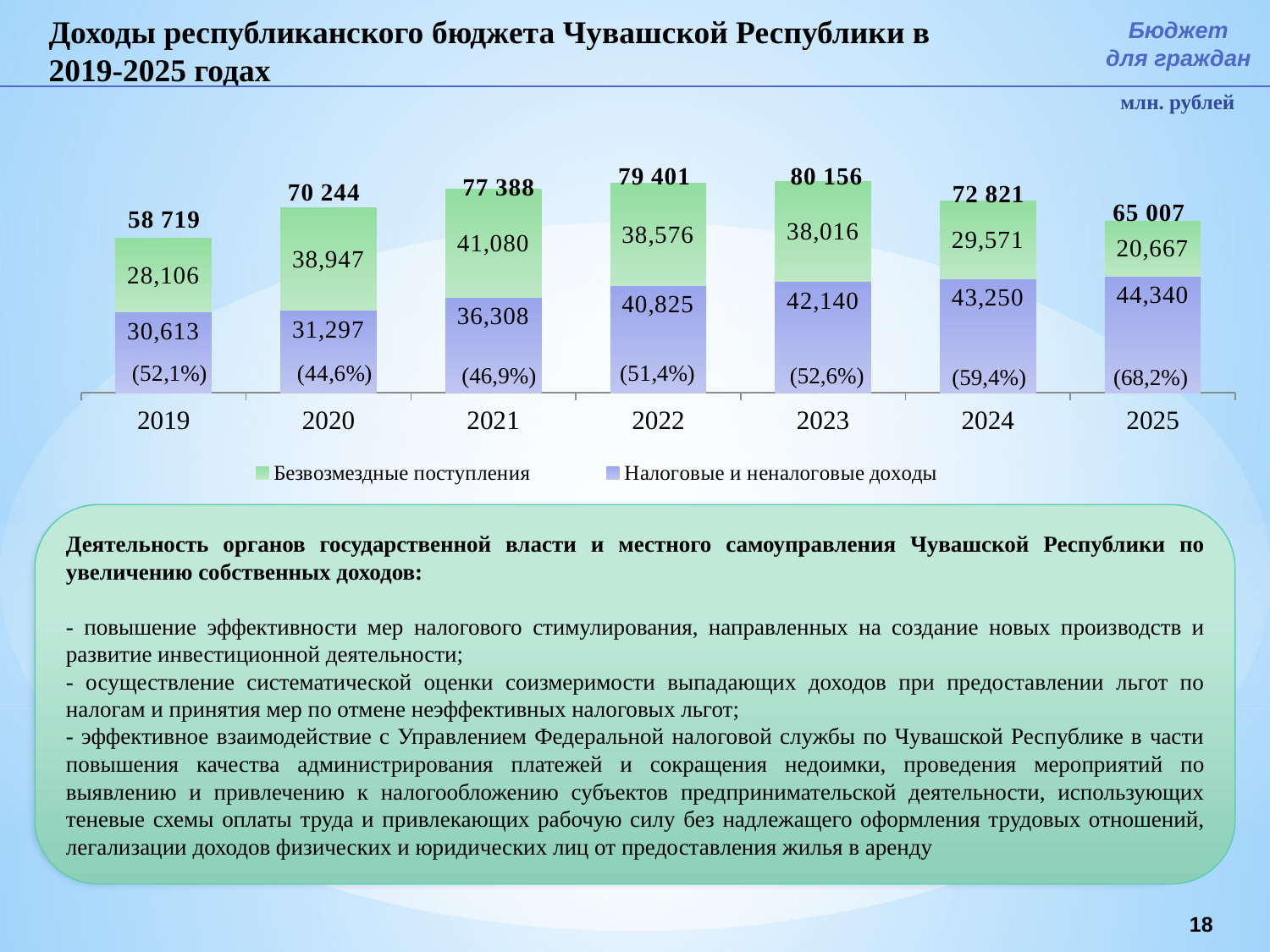
What is the difference between Налоговые и неналоговые доходы in 2025 and in 2019? 13,727 How many years are shown on the x axis? 7 Do the values of Налоговые и неналоговые доходы rise or fall from 2019 to 2025? Rise What kind of chart is shown on the slide? Stacked bar chart What is the value of Налоговые и неналоговые доходы for 2022? 40,825 How many series does the legend list? 2 Which year has the lowest total revenue? 2019 What percentage is shown in parentheses for 2025? (68,2%) What is the total revenue shown above the bar for 2024? 72 821 Which year has the highest total revenue? 2023 Which is larger in 2020: Безвозмездные поступления or Налоговые и неналоговые доходы? Безвозмездные поступления What is the value of Безвозмездные поступления for 2021? 41,080